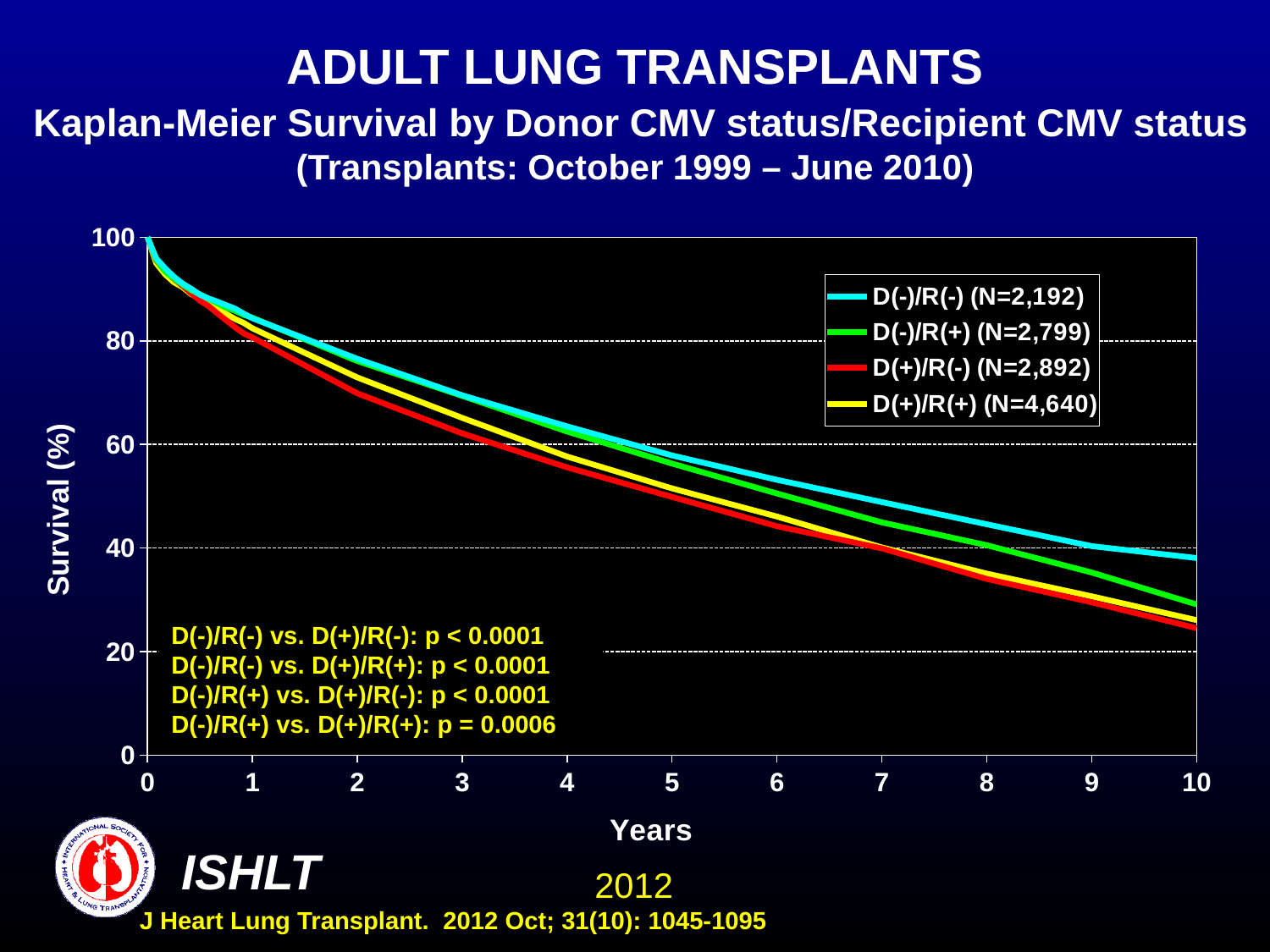
What is the N for the D(-)/R(-) group shown in the legend? 2,192 Is the survival for D(-)/R(-) at 10 years greater or less than 40? less Is the survival for D(+)/R(-) at 10 years greater or less than 20? greater What kind of chart is shown on the slide? Line chart What is the N for the D(+)/R(+) group shown in the legend? 4,640 Do the survival curves rise or fall as years increase? Fall Which group has the largest N in the legend? D(+)/R(+) (N=4,640) How many series does the legend list? 4 At 5 years, which group has higher survival: D(-)/R(+) or D(+)/R(-)? D(-)/R(+) What is the label of the y-axis? Survival (%) Which group has the lowest survival at 10 years? D(+)/R(-) Which group has the highest survival at 10 years? D(-)/R(-)